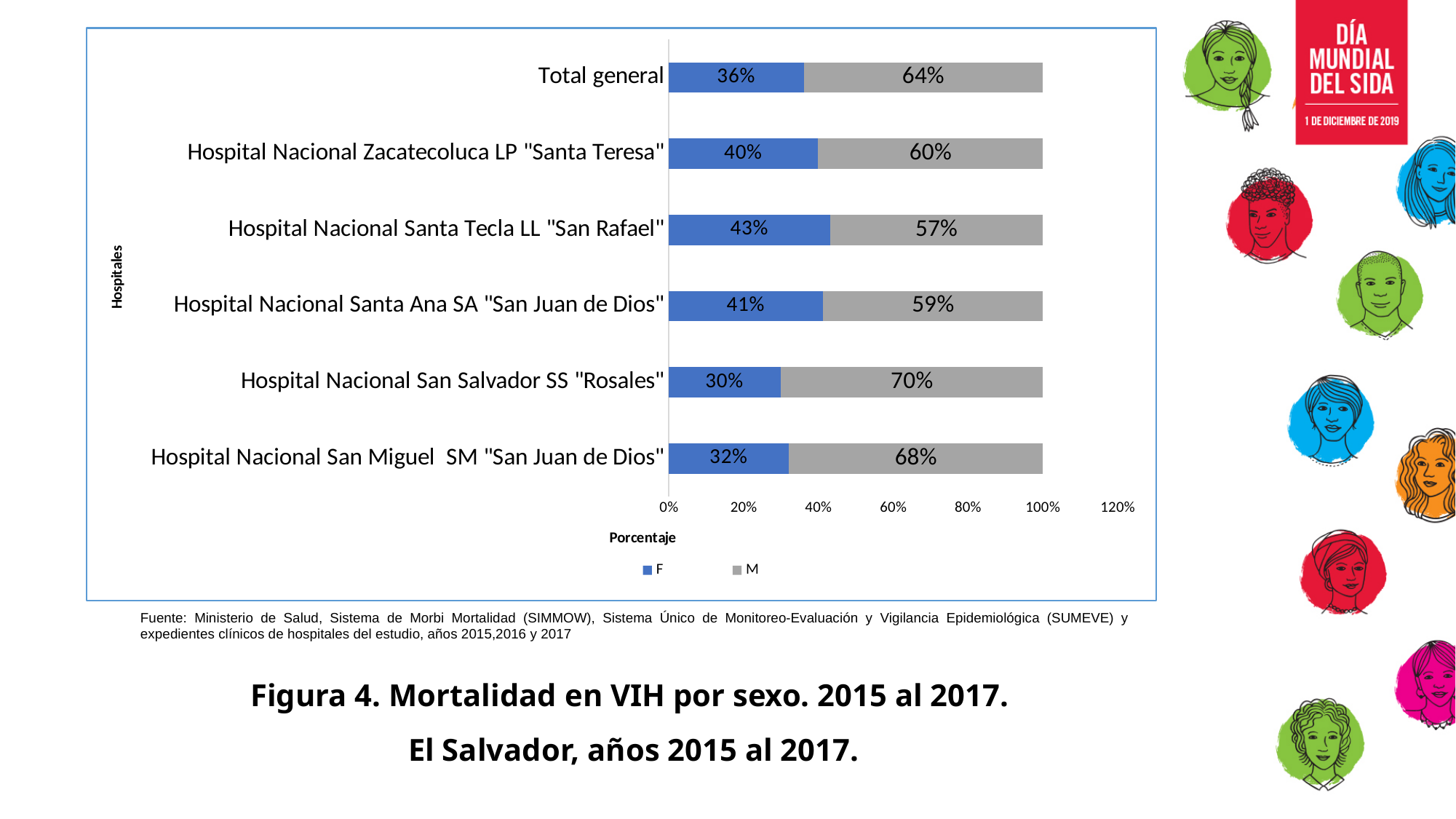
What is the F value for Hospital Nacional San Salvador SS "Rosales"? 30% Which is larger: the F value for Hospital Nacional Santa Ana SA "San Juan de Dios" or the F value for Hospital Nacional San Miguel SM "San Juan de Dios"? Hospital Nacional Santa Ana SA "San Juan de Dios" What is the total of the stacked bar for Hospital Nacional Santa Ana SA "San Juan de Dios"? 100% What is the M value for Hospital Nacional San Miguel SM "San Juan de Dios"? 68% What is the M value for Total general? 64% How many series does the legend list? 2 What is the difference between the M and F values for Hospital Nacional Zacatecoluca LP "Santa Teresa"? 20% Which hospital has the highest F percentage? Hospital Nacional Santa Tecla LL "San Rafael" What kind of chart is shown? Stacked bar chart How many categories (bars) are shown on the chart? 6 Which hospital has the lowest F percentage? Hospital Nacional San Salvador SS "Rosales" What is the F value for Hospital Nacional Santa Tecla LL "San Rafael"? 43%